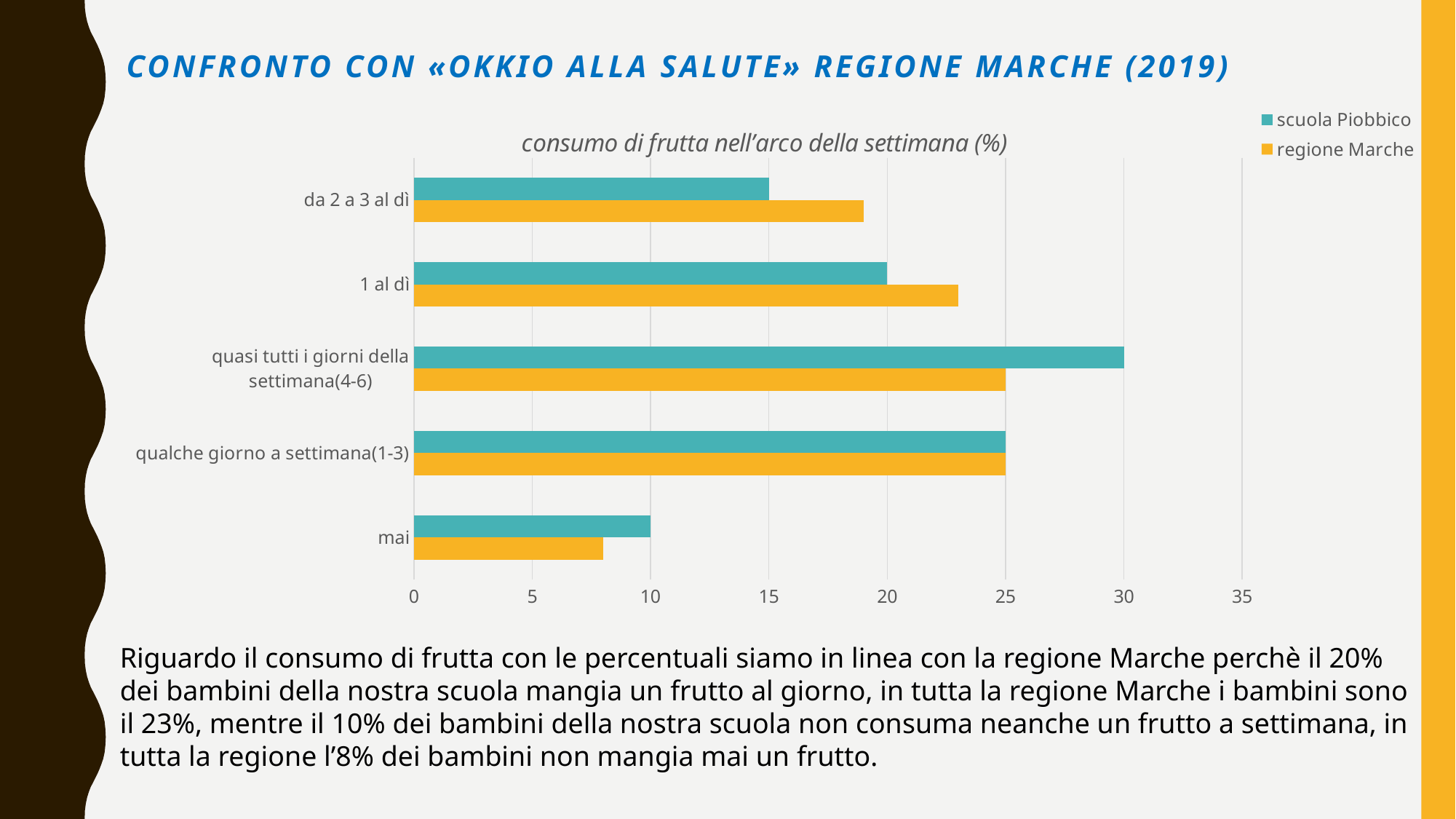
What is the value for regione Marche in the category 'qualche giorno a settimana(1-3)'? 25 Is the value for regione Marche in the category 'mai' greater or less than 10? less In the category 'da 2 a 3 al dì', which series has the larger value, scuola Piobbico or regione Marche? regione Marche Which category has the highest value for scuola Piobbico? quasi tutti i giorni della settimana(4-6) Which category has the lowest value for scuola Piobbico? mai What kind of chart is shown on the slide? bar chart How many categories are shown on the y axis of the chart? 5 What is the difference between the scuola Piobbico values for 'quasi tutti i giorni della settimana(4-6)' and '1 al dì'? 10 What is the value for scuola Piobbico in the category 'mai'? 10 What is the title of the chart? consumo di frutta nell'arco della settimana (%) How many series does the legend list? 2 What is the value for scuola Piobbico in the category 'quasi tutti i giorni della settimana(4-6)'? 30